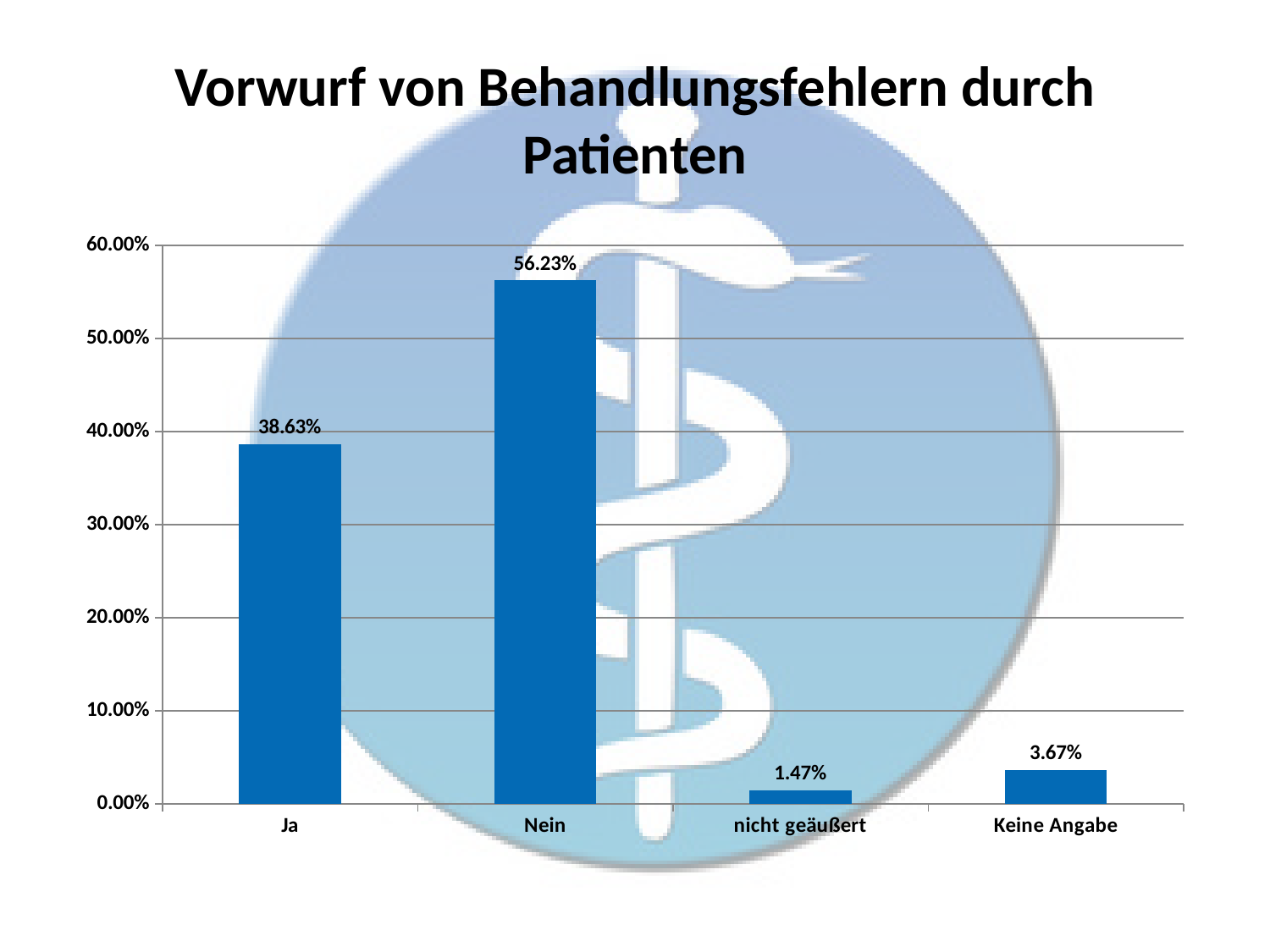
What is the value for "Nein"? 56.23% Which category has the highest value? Nein Is the value for "Ja" greater or less than 40.00%? less What is the value for "nicht geäußert"? 1.47% What is the difference between the values for "Nein" and "Ja"? 17.60% What is the value for "Ja"? 38.63% What kind of chart is shown on the slide? bar chart What is the value for "Keine Angabe"? 3.67% What is the title of the chart? Vorwurf von Behandlungsfehlern durch Patienten How many categories are shown on the x axis? 4 Which category has the lowest value? nicht geäußert Which is larger, the value for "Keine Angabe" or the value for "nicht geäußert"? Keine Angabe